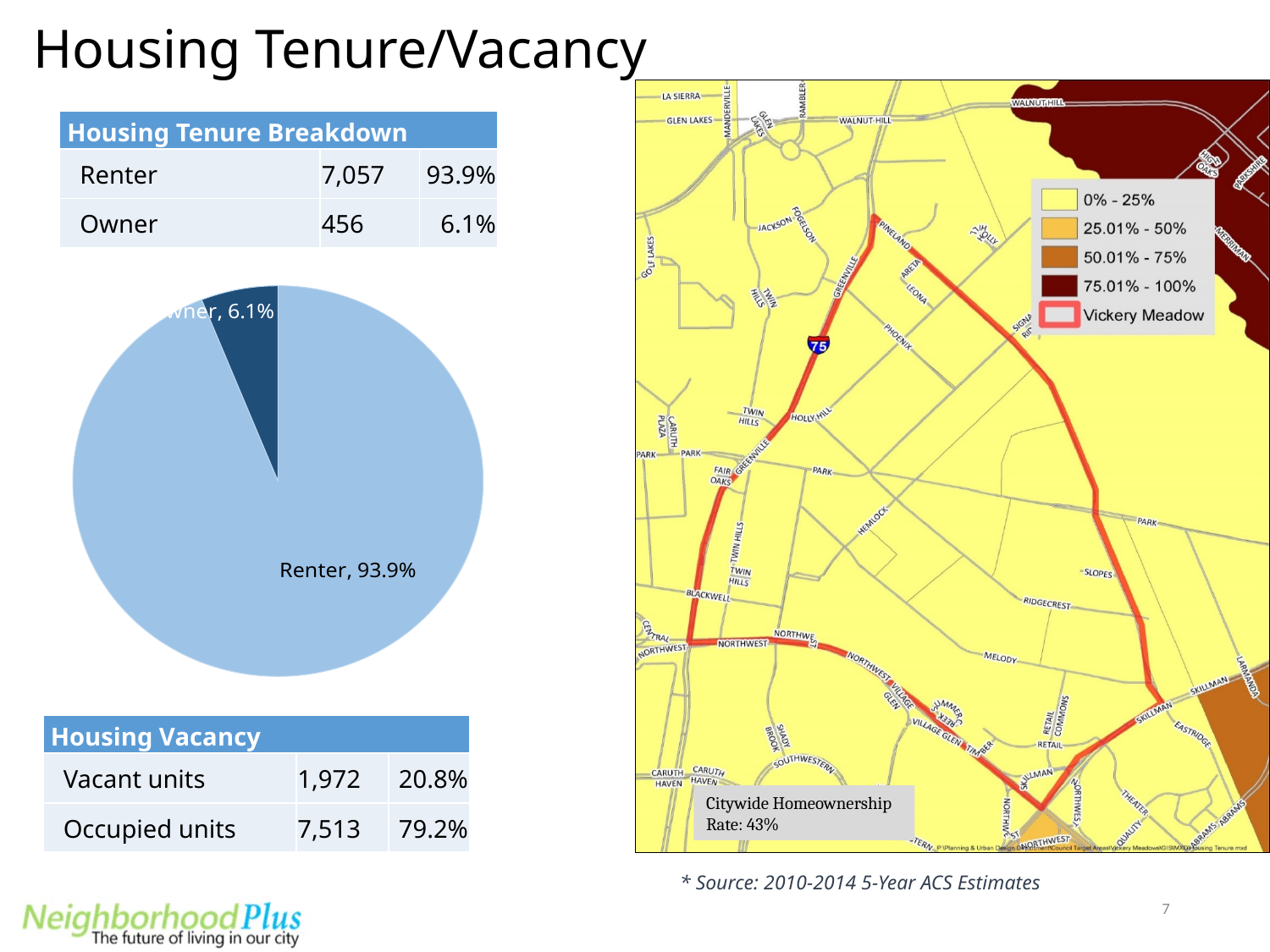
In the pie chart, what share is labelled for Renter? 93.9% In the pie chart, what share is labelled for Owner? 6.1% Which slice of the pie chart is the largest? Renter What colour is the Owner slice in the pie chart? Dark blue Is the Renter share in the pie chart greater or less than 90%? greater What share of the pie chart does the Owner slice represent? 6.1% What colour is the Renter slice in the pie chart? Light blue By how many percentage points does the Renter share exceed the Owner share in the pie chart? 87.8 percentage points What type of chart is shown on the left of the slide? Pie chart How many slices does the pie chart have? 2 In the pie chart, which is larger, the Renter slice or the Owner slice? Renter Which slice of the pie chart is the smallest? Owner